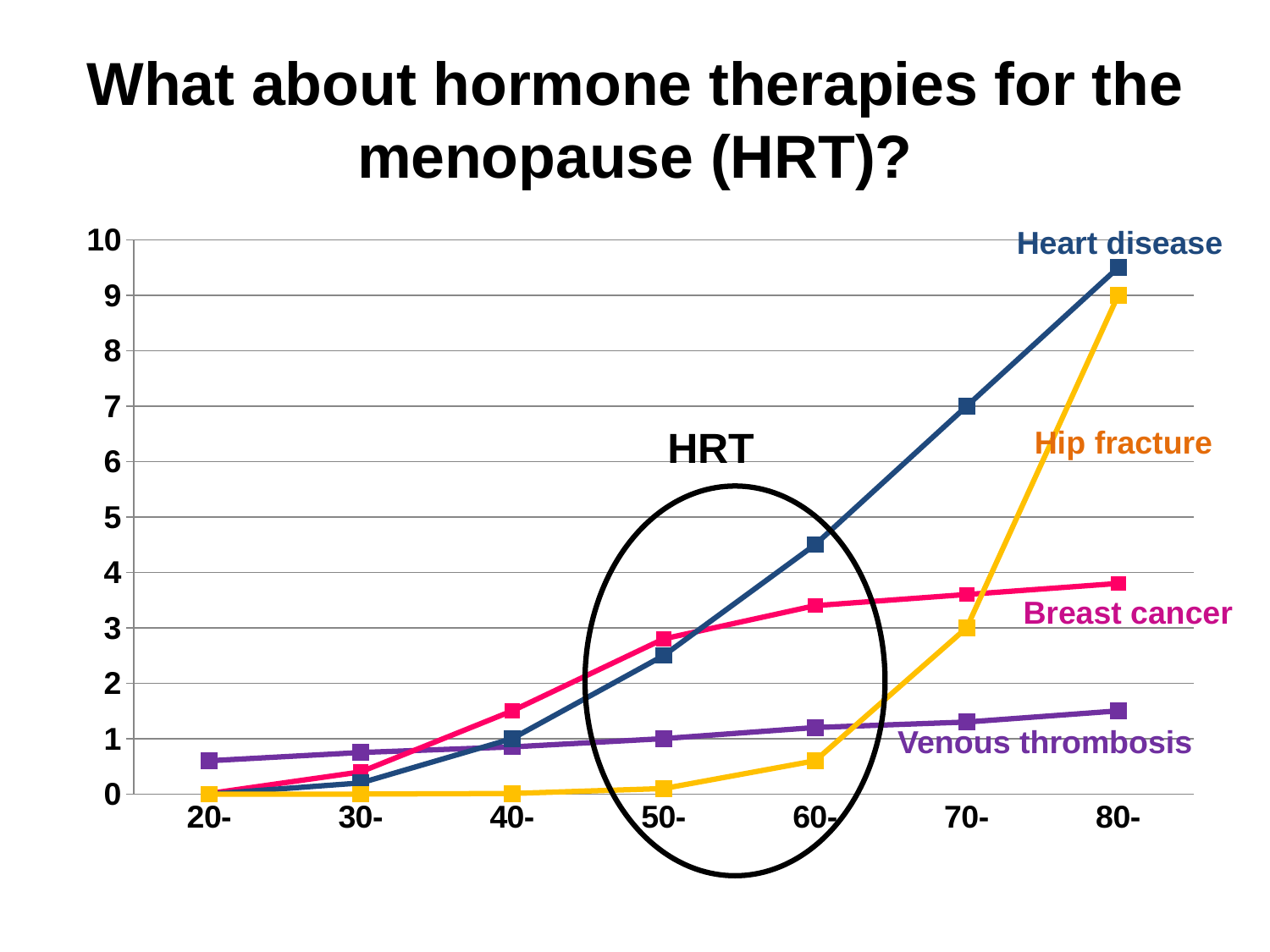
At 60-, which is larger: Heart disease or Breast cancer? Heart disease Is the value for Heart disease at 60- greater or less than 4? greater How many series are labelled on the chart? 4 What is the value for Hip fracture at 70-? 3 Which series has the highest value at 80-? Heart disease What is the value for Hip fracture at 80-? 9 What kind of chart is shown on the slide? line chart Is the value for Hip fracture at 60- greater or less than 1? less What is the value for Heart disease at 70-? 7 Which series has the lowest value at 80-? Venous thrombosis Does the Heart disease line rise or fall from 20- to 80-? rise How many age categories are shown on the x axis? 7